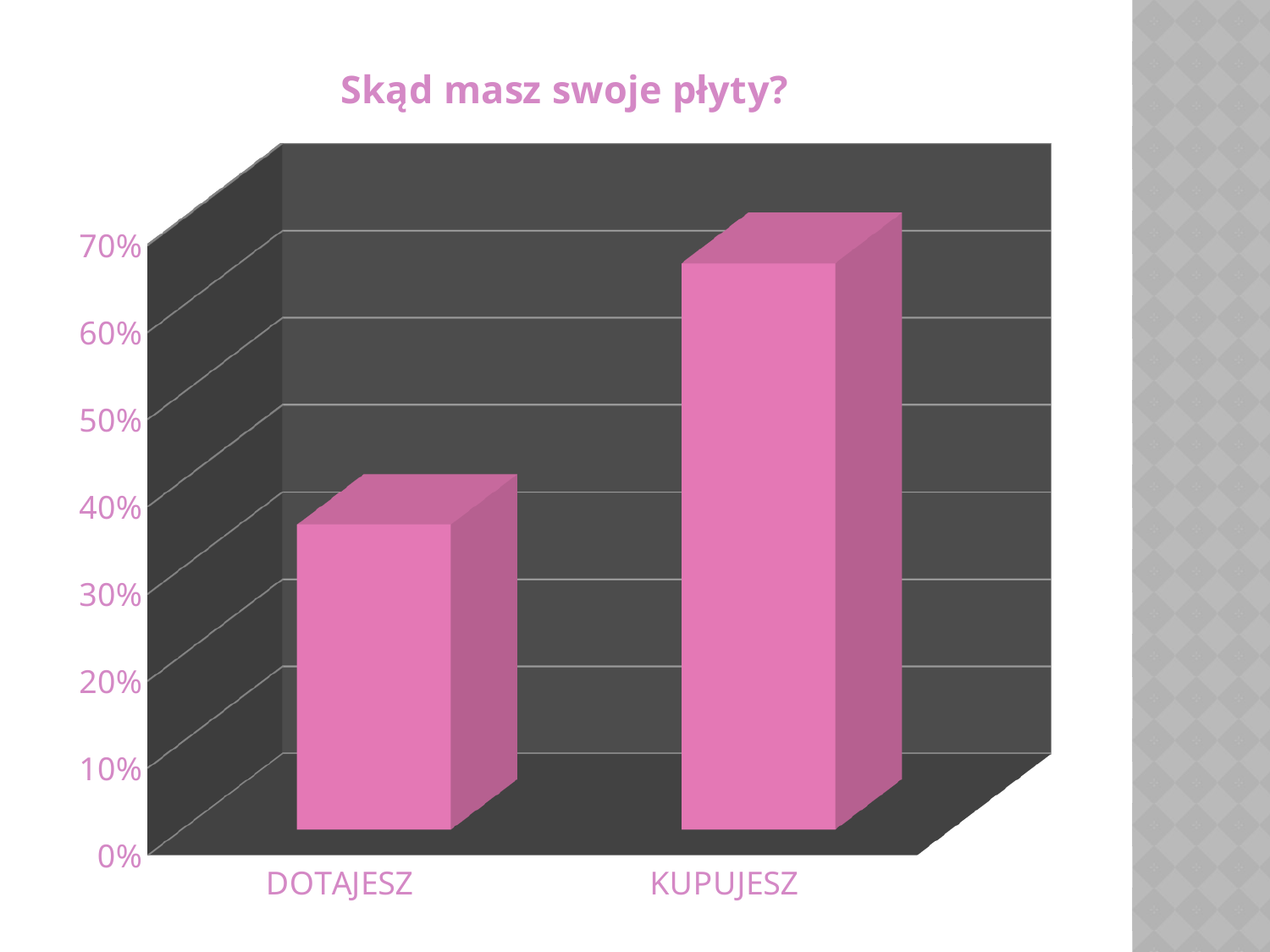
Which category has the highest value in the chart? KUPUJESZ Which category has the lowest value in the chart? DOTAJESZ What kind of chart is shown on the slide? bar chart How many categories are shown on the x axis of the chart? 2 Is the value for DOTAJESZ greater or less than 20%? greater What is the title of the chart? Skąd masz swoje płyty? What colour are the bars in the chart? pink Is the value for KUPUJESZ greater or less than 50%? greater Is the value for KUPUJESZ greater or less than 70%? less Which is larger, the value for DOTAJESZ or the value for KUPUJESZ? KUPUJESZ